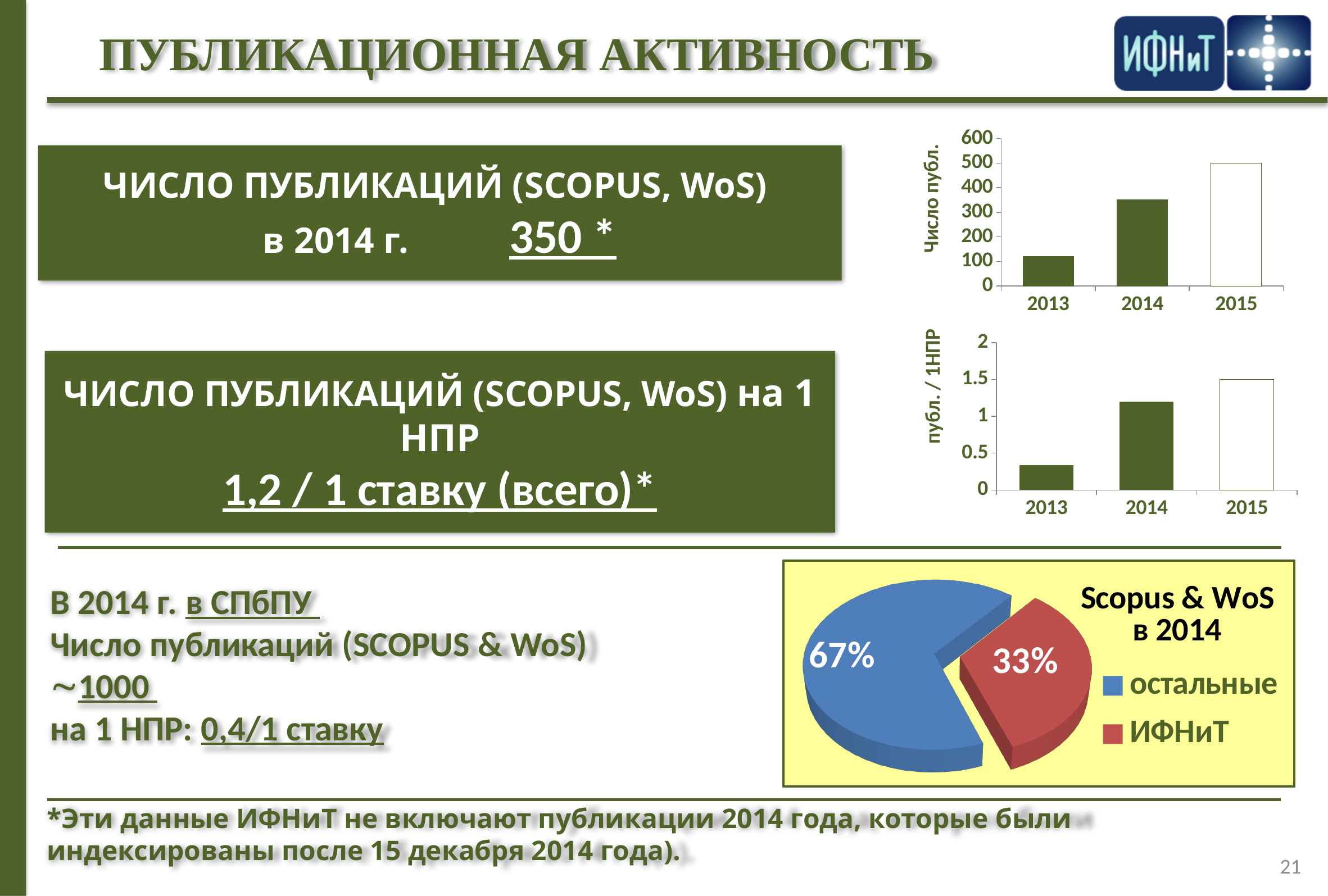
In the middle bar chart (публ. / 1НПР), is the value for 2013 greater or less than 0.5? less In the middle bar chart (публ. / 1НПР), which is larger, the value for 2014 or the value for 2013? 2014 In the pie chart 'Scopus & WoS в 2014', how many entries does the legend list? 2 In the top bar chart (Число публ.), which year has the highest bar? 2015 In the middle bar chart (публ. / 1НПР), what value does the 2015 bar reach on the axis? 1.5 In the top bar chart (Число публ.), is the value for 2013 greater or less than 200? less In the top bar chart (Число публ.), how many years are shown on the x axis? 3 In the pie chart 'Scopus & WoS в 2014', what share does ИФНиТ have? 33% What kind of chart is the chart titled 'Scopus & WoS в 2014'? pie chart In the top bar chart (Число публ.), do the values rise or fall from 2013 to 2015? rise In the top bar chart (Число публ.), what value does the 2015 bar reach on the axis? 500 In the top bar chart (Число публ.), which year has the lowest bar? 2013